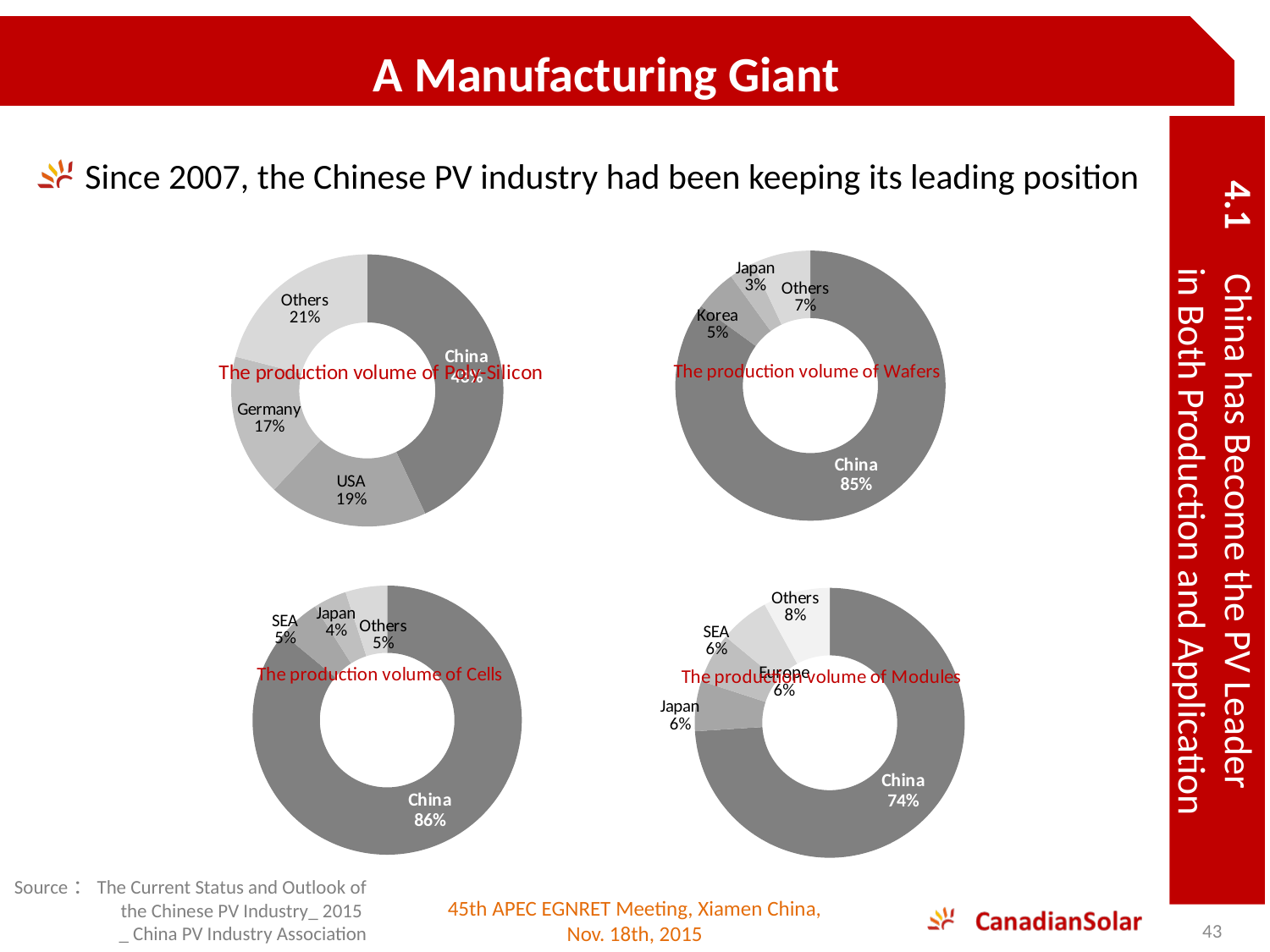
In the chart titled 'The production volume of Modules', what share does China hold? 74% In the chart titled 'The production volume of Cells', what share does China hold? 86% How many charts are shown on the slide? 4 In the chart titled 'The production volume of Wafers', what share does China hold? 85% In the chart titled 'The production volume of Cells', which category has the largest share? China How many categories are shown in the chart titled 'The production volume of Modules'? 5 In the chart titled 'The production volume of Poly-Silicon', which is larger, the share of Others or the share of Germany? Others In the chart titled 'The production volume of Poly-Silicon', what share does the USA hold? 19% In the chart titled 'The production volume of Wafers', what is the difference between the shares of Korea and Japan? 2% In the chart titled 'The production volume of Wafers', which category has the smallest share? Japan What kind of chart is 'The production volume of Cells'? Doughnut chart In the chart titled 'The production volume of Poly-Silicon', what share does Germany hold? 17%